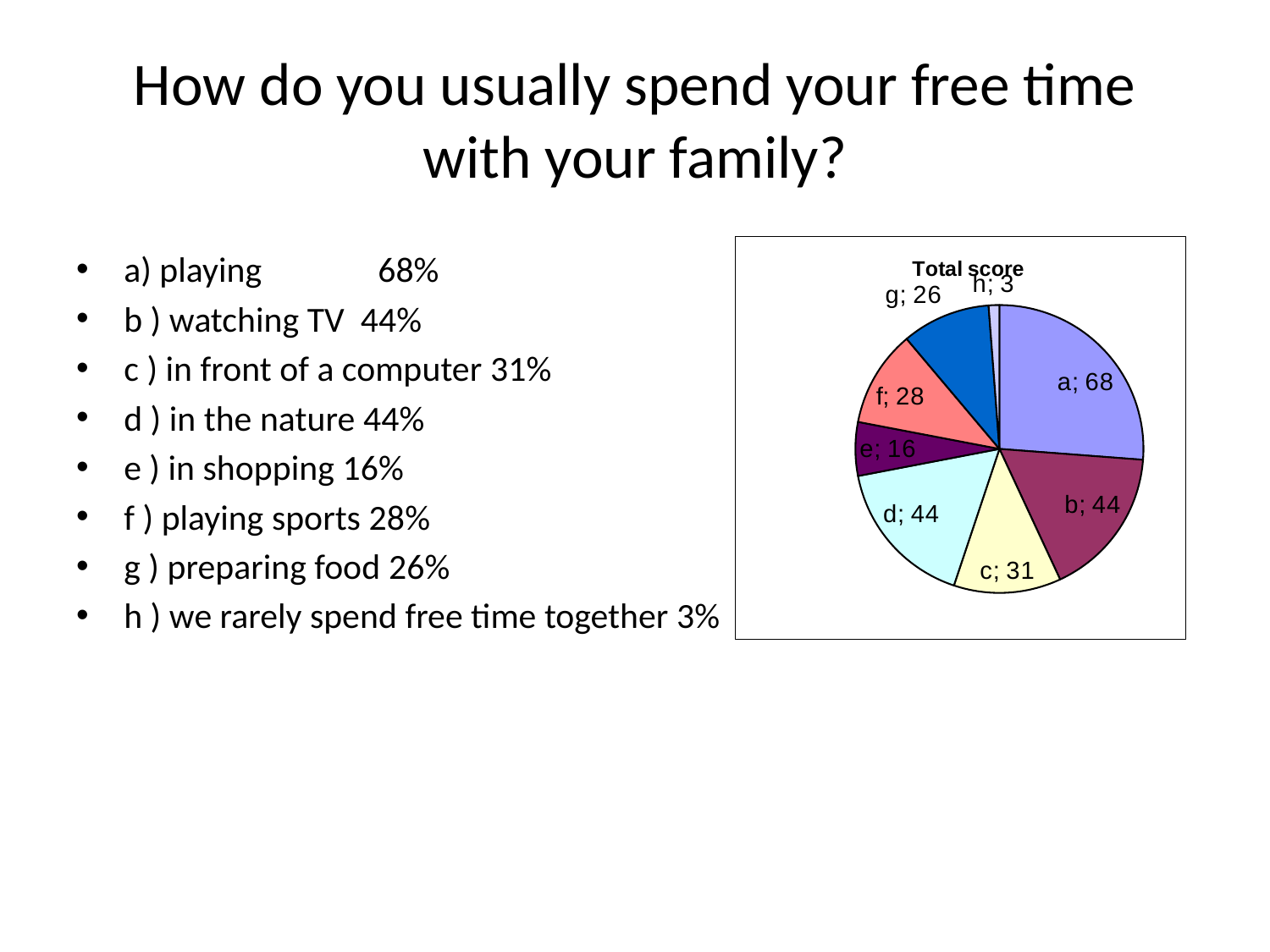
How many slices does the pie chart have? 8 Which slice has a larger value, c or e? c What is the title of the chart? Total score What is the difference between the values of slice a and slice b? 24 What is the value shown for slice f in the pie chart? 28 What type of chart is shown on the slide? pie chart Which slice has the largest value in the pie chart? a What is the difference between the values of slice f and slice g? 2 What is the value shown for slice c in the pie chart? 31 Which slice has the smallest value in the pie chart? h What is the value shown for slice a in the pie chart? 68 What is the value shown for slice h in the pie chart? 3